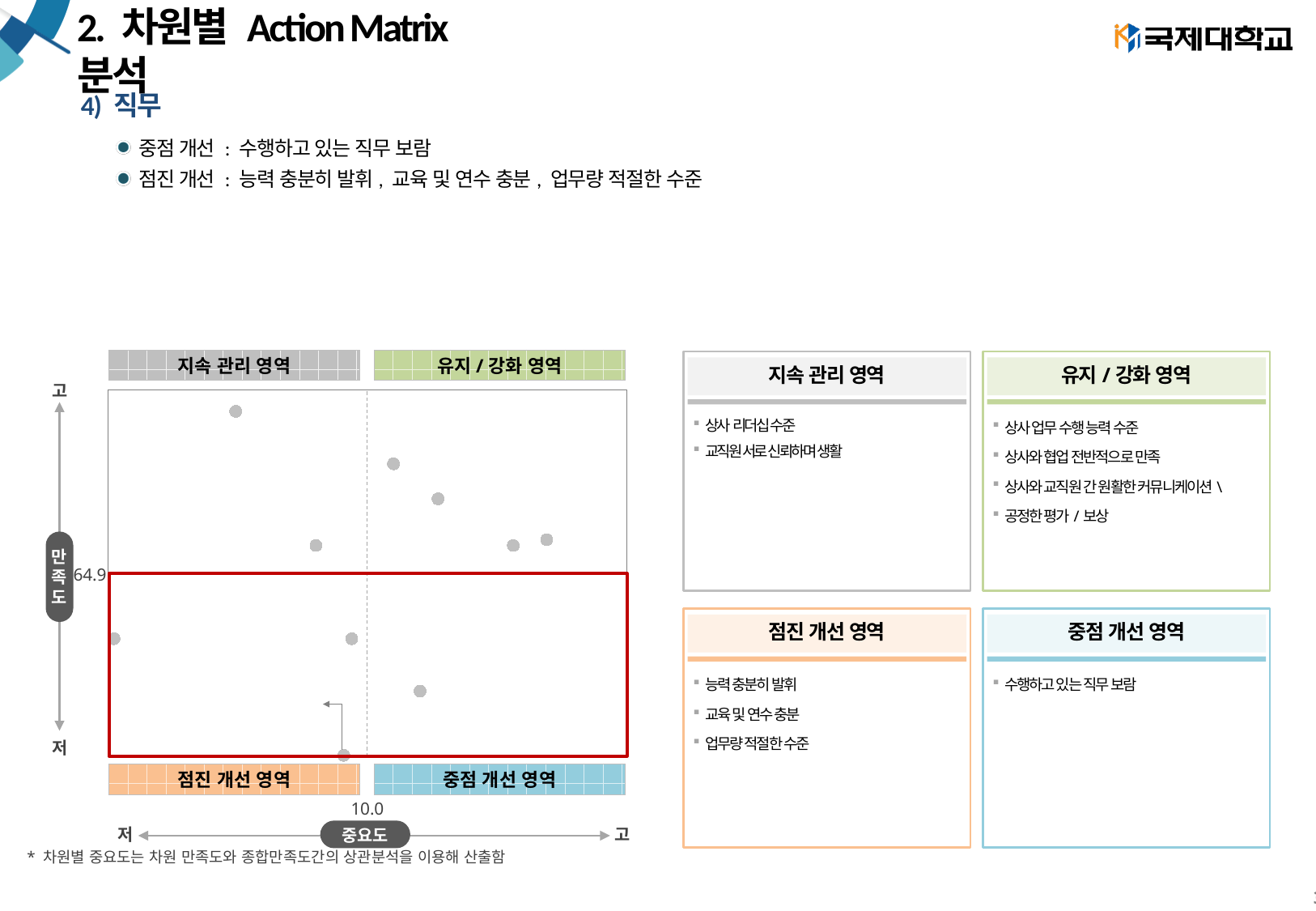
What satisfaction (만족도) value marks the horizontal dividing line in the action matrix chart? 64.9 What importance (중요도) value marks the vertical dividing line in the action matrix chart? 10.0 How many data points fall in the 중점 개선 영역 (lower right) quadrant of the chart? 1 How many data points fall in the 지속 관리 영역 (upper left) quadrant of the chart? 2 How many data points are plotted in the action matrix chart? 10 What is the label of the horizontal axis in the action matrix chart? 중요도 Which quadrant of the action matrix chart contains the fewest data points? 중점 개선 영역 What is the label of the vertical axis in the action matrix chart? 만족도 What kind of chart is shown on the left of the slide? scatter chart Which quadrant of the action matrix chart contains the most data points? 유지 / 강화 영역